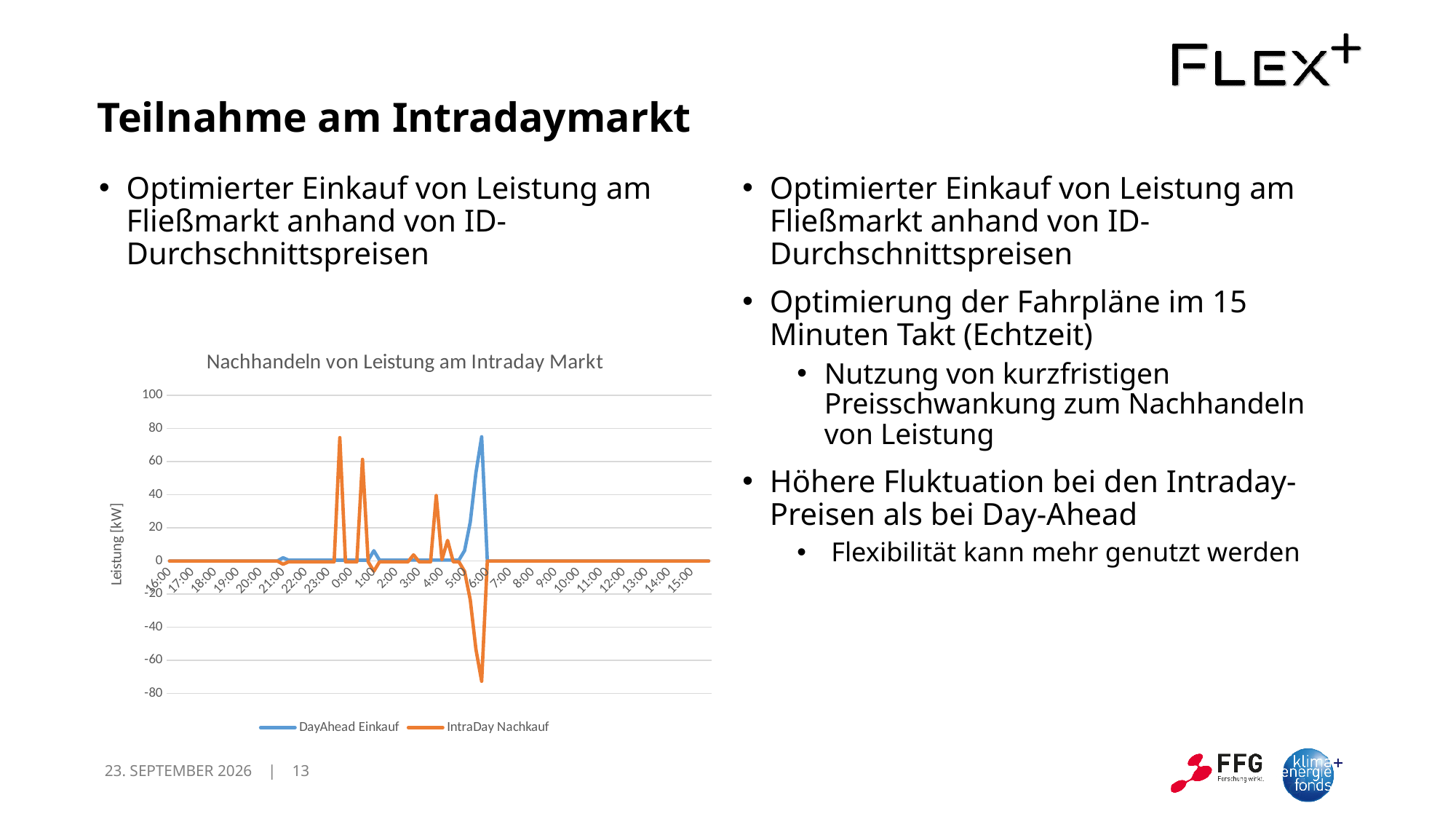
Is the lowest value of the IntraDay Nachkauf series greater or less than -60? less Is the value of the DayAhead Einkauf series at 10:00 greater or less than 20? less How many series does the legend of the chart list? 2 What is the label of the y axis of the chart? Leistung [kW] Is the highest value of the DayAhead Einkauf series greater or less than 60? greater What kind of chart is shown on the slide? line chart What is the title of the chart? Nachhandeln von Leistung am Intraday Markt Which series drops below zero in the chart? IntraDay Nachkauf Which series reaches the lowest value in the chart? IntraDay Nachkauf How many time labels are shown along the x axis of the chart? 24